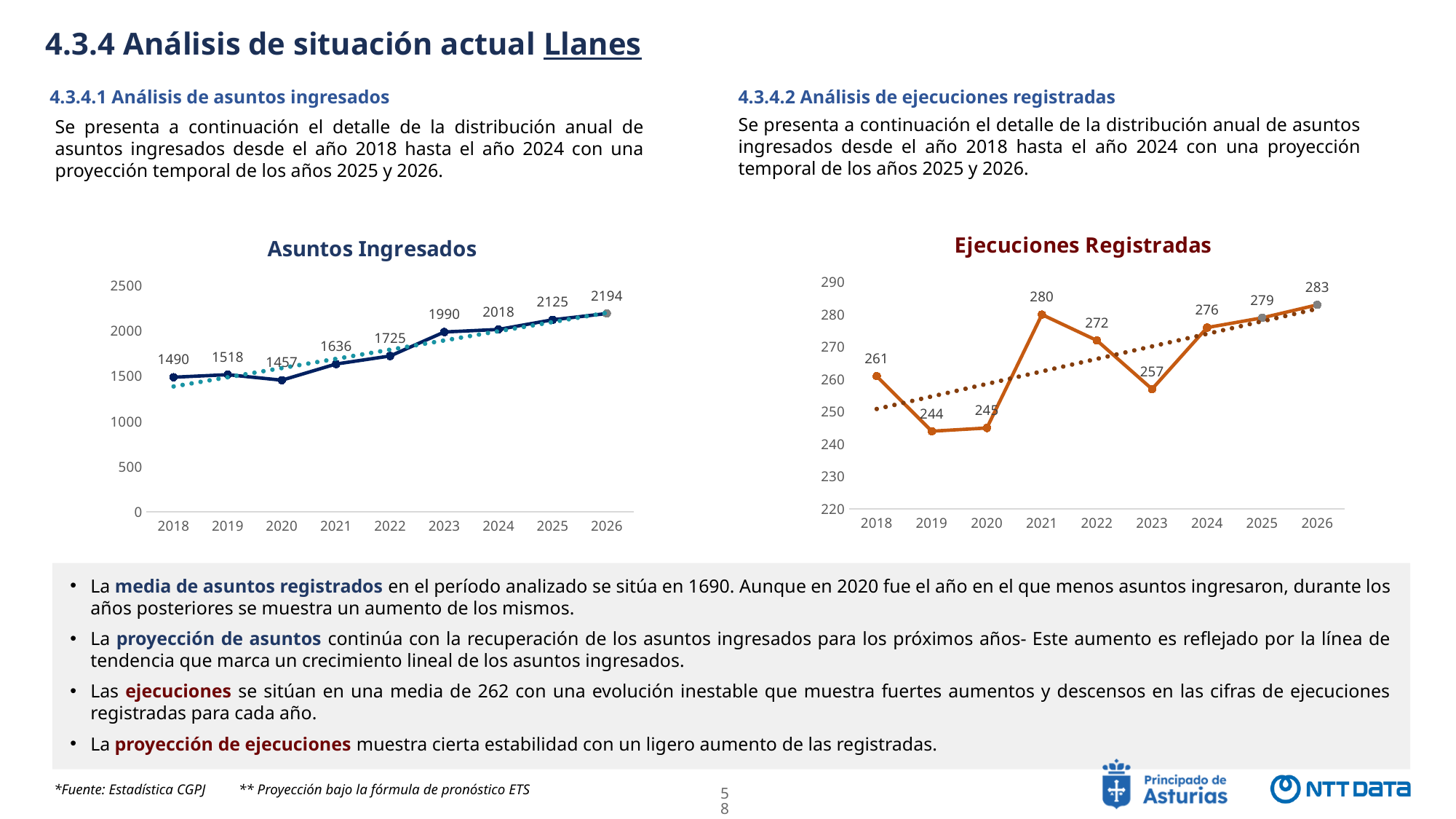
In the 'Asuntos Ingresados' chart, what is the value for 2026? 2194 In the 'Asuntos Ingresados' chart, how many years are shown on the x axis? 9 In the 'Ejecuciones Registradas' chart, what is the difference between the values for 2021 and 2020? 35 What kind of chart is the 'Ejecuciones Registradas' chart? Line chart In the 'Asuntos Ingresados' chart, is the value for 2021 greater or less than 1500? greater In the 'Ejecuciones Registradas' chart, which is larger, the value for 2018 or the value for 2023? 2018 In the 'Asuntos Ingresados' chart, what is the difference between the values for 2023 and 2022? 265 In the 'Ejecuciones Registradas' chart, which year has the lowest value? 2019 In the 'Ejecuciones Registradas' chart, which year has the highest value? 2026 In the 'Ejecuciones Registradas' chart, what is the value for 2021? 280 In the 'Asuntos Ingresados' chart, which year has the lowest value? 2020 In the 'Asuntos Ingresados' chart, what is the value for 2020? 1457